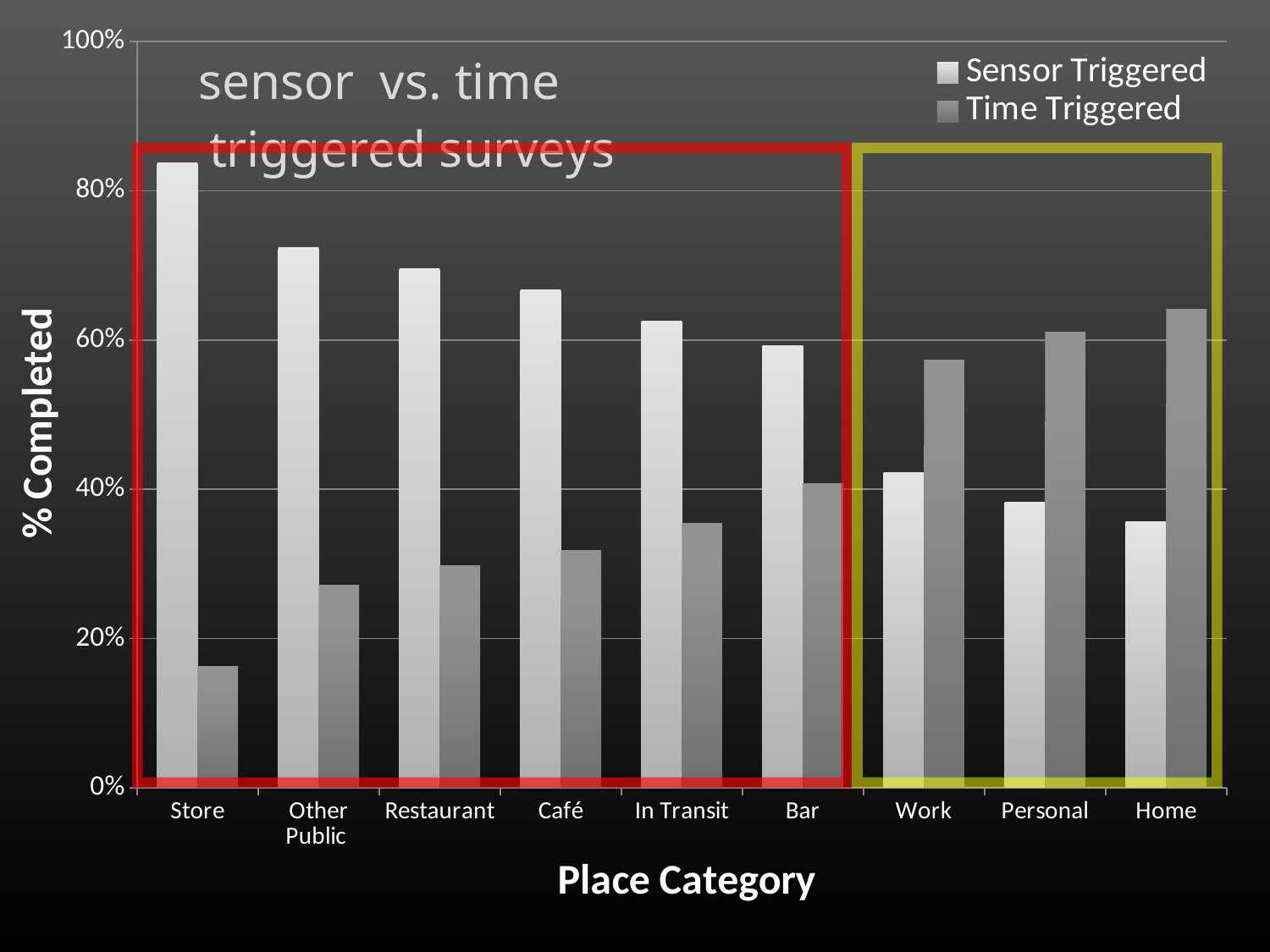
Is the Time Triggered value for Home greater or less than 60%? greater Which place category has the lowest Time Triggered value? Store How many series does the legend list? 2 Is the Sensor Triggered value for Store greater or less than 80%? greater Which place category has the highest Time Triggered value? Home How many place categories are shown on the x axis? 9 Is the Time Triggered value for Store greater or less than 20%? less What kind of chart is shown on the slide? bar chart For Work, which is larger: the Sensor Triggered value or the Time Triggered value? Time Triggered Do the Sensor Triggered values generally rise or fall moving from Store to Home along the x axis? fall Which place category has the highest Sensor Triggered value? Store What is the label of the y axis? % Completed